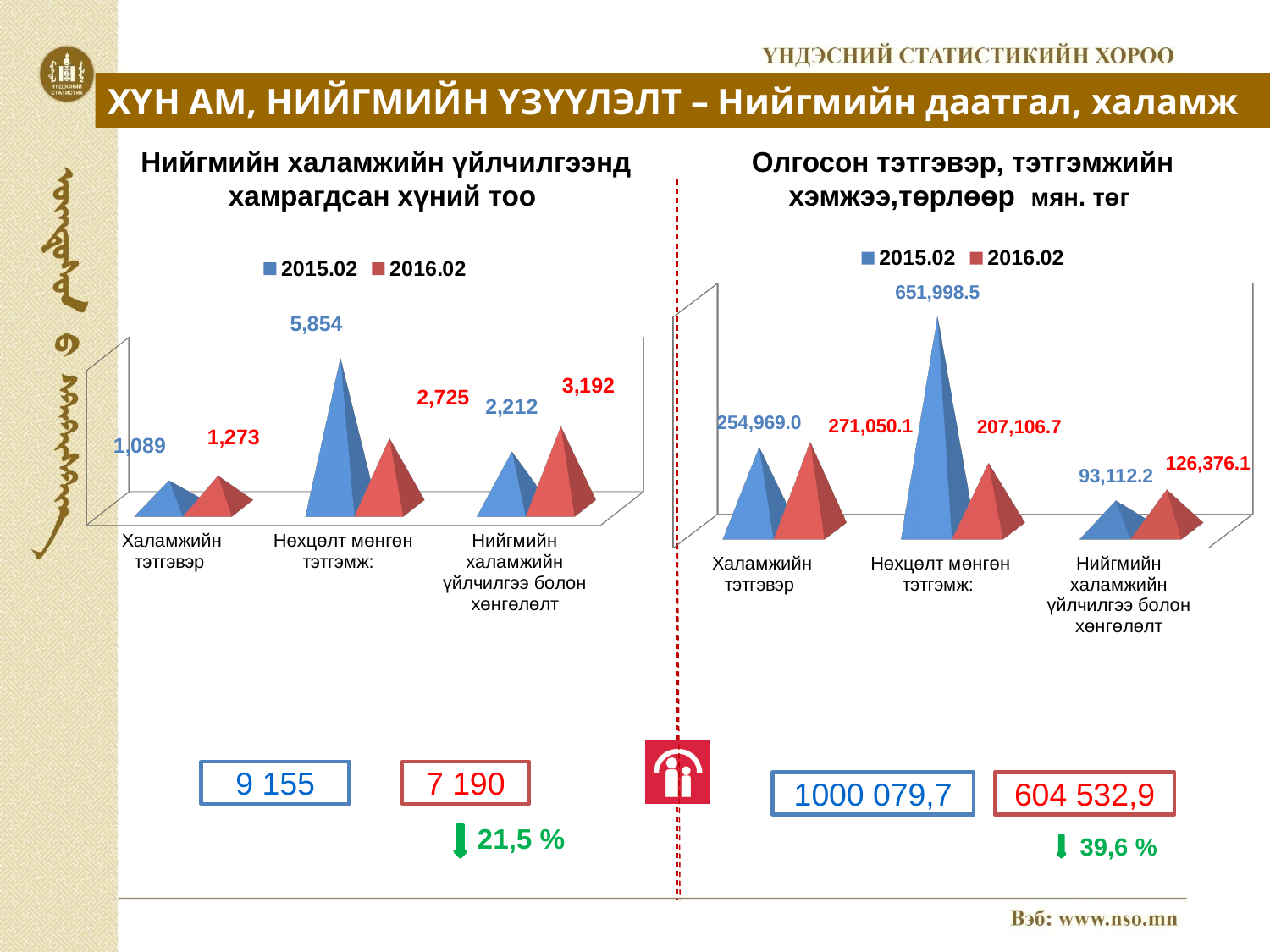
In the right chart (Олгосон тэтгэвэр, тэтгэмжийн хэмжээ, төрлөөр), what is the 2015.02 value for Нөхцөлт мөнгөн тэтгэмж? 651,998.5 How many categories are shown on the x axis of the right chart (Олгосон тэтгэвэр, тэтгэмжийн хэмжээ, төрлөөр)? 3 In the left chart (Нийгмийн халамжийн үйлчилгээнд хамрагдсан хүний тоо), what is the 2015.02 value for Нөхцөлт мөнгөн тэтгэмж? 5,854 In the left chart (Нийгмийн халамжийн үйлчилгээнд хамрагдсан хүний тоо), which category has the highest 2015.02 value? Нөхцөлт мөнгөн тэтгэмж In the right chart (Олгосон тэтгэвэр, тэтгэмжийн хэмжээ, төрлөөр), which category has the lowest 2015.02 value? Нийгмийн халамжийн үйлчилгээ болон хөнгөлөлт In the right chart (Олгосон тэтгэвэр, тэтгэмжийн хэмжээ, төрлөөр), which is larger for Халамжийн тэтгэвэр: the 2015.02 value or the 2016.02 value? 2016.02 What kind of chart is the left chart (Нийгмийн халамжийн үйлчилгээнд хамрагдсан хүний тоо)? bar chart In the left chart (Нийгмийн халамжийн үйлчилгээнд хамрагдсан хүний тоо), what is the 2016.02 value for Халамжийн тэтгэвэр? 1,273 In the left chart (Нийгмийн халамжийн үйлчилгээнд хамрагдсан хүний тоо), which is larger for Нийгмийн халамжийн үйлчилгээ болон хөнгөлөлт: the 2015.02 value or the 2016.02 value? 2016.02 How many series does the legend of the left chart (Нийгмийн халамжийн үйлчилгээнд хамрагдсан хүний тоо) list? 2 In the left chart (Нийгмийн халамжийн үйлчилгээнд хамрагдсан хүний тоо), what is the difference between the 2015.02 and 2016.02 values for Нөхцөлт мөнгөн тэтгэмж? 3,129 In the right chart (Олгосон тэтгэвэр, тэтгэмжийн хэмжээ, төрлөөр), what is the 2016.02 value for Нийгмийн халамжийн үйлчилгээ болон хөнгөлөлт? 126,376.1